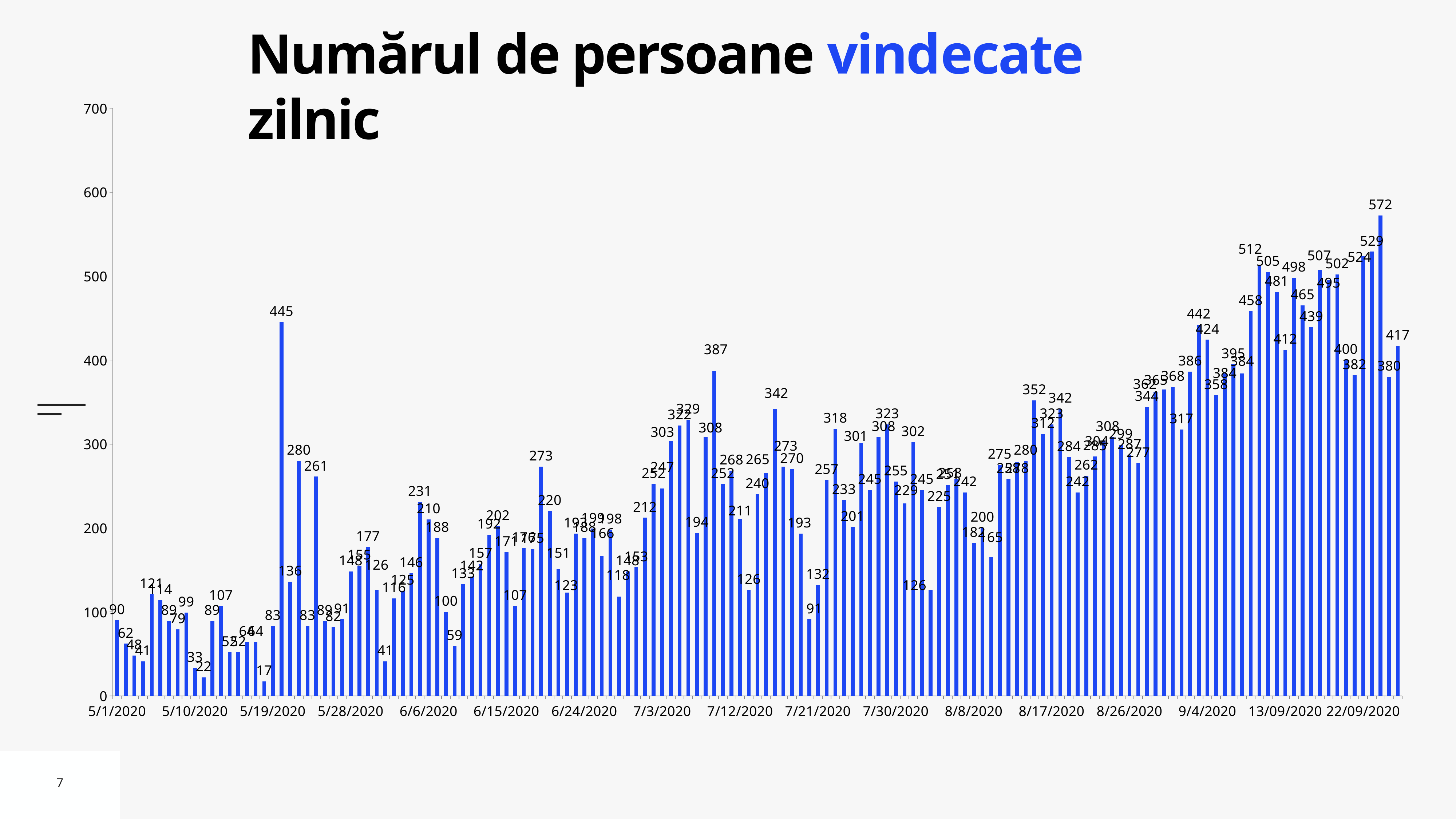
What is the highest daily value shown on the chart? 572 Is the value of the tallest bar greater or less than 500? greater Do the daily values generally rise or fall from May to September 2020? rise What is the difference between the highest bar (572) and the bar immediately before it (529)? 43 What is the lowest daily value shown on the chart? 17 What is the maximum value shown on the vertical axis? 700 What is the value of the first bar, dated 5/1/2020? 90 What is the title of the chart? Numărul de persoane vindecate zilnic Which is larger, the first bar (5/1/2020) or the last bar on the chart? the last bar What is the value of the tallest bar in May 2020? 445 What kind of chart is shown on the slide? bar chart What is the value of the last bar on the right of the chart? 417